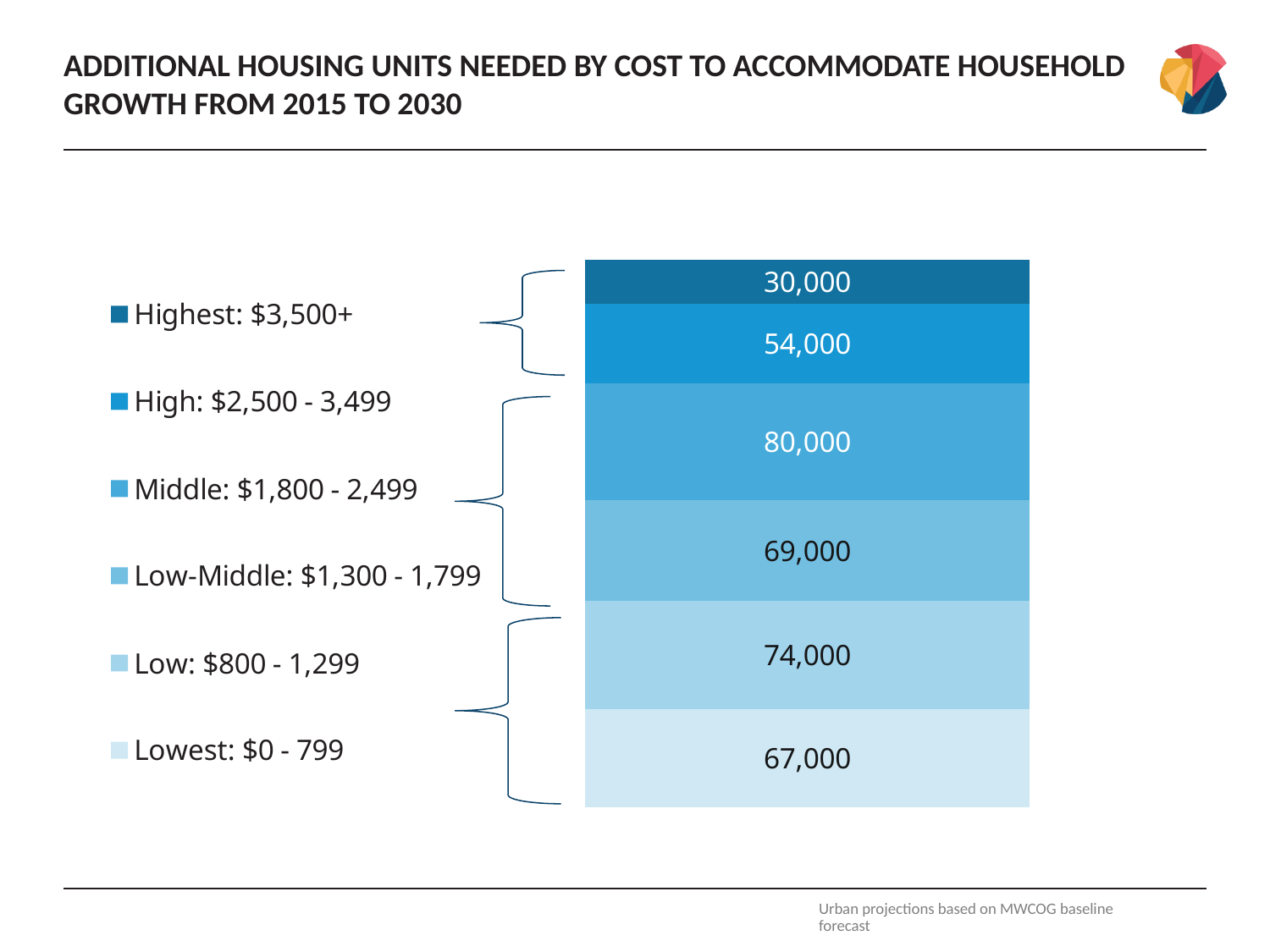
What is the total number of additional housing units needed across all cost categories in the stacked bar? 374,000 Which needs more additional housing units, the Low: $800 - 1,299 category or the Low-Middle: $1,300 - 1,799 category? Low: $800 - 1,299 How many additional housing units are needed in the Highest: $3,500+ cost category? 30,000 How many additional housing units are needed in the Low: $800 - 1,299 cost category? 74,000 What kind of chart is shown on the slide? Stacked bar chart What is the difference between the units needed in the High: $2,500 - 3,499 category and the Highest: $3,500+ category? 24,000 Which cost category needs the most additional housing units? Middle: $1,800 - 2,499 What is the title of the chart on the slide? Additional Housing Units Needed by Cost to Accommodate Household Growth from 2015 to 2030 How many additional housing units are needed in the Lowest: $0 - 799 cost category? 67,000 How many cost categories are shown in the stacked bar? 6 Which cost category needs the fewest additional housing units? Highest: $3,500+ How many additional housing units are needed in the Middle: $1,800 - 2,499 cost category? 80,000